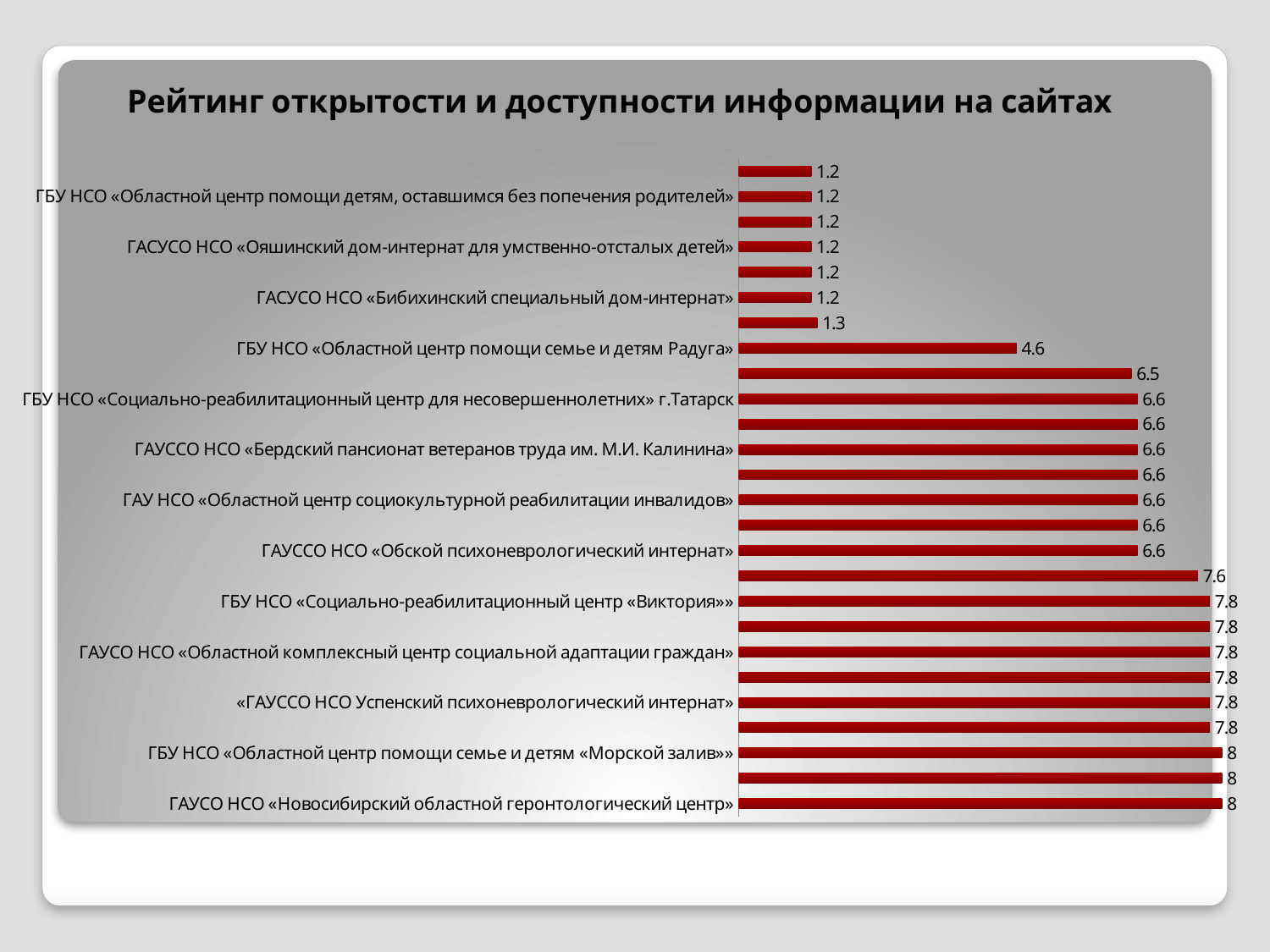
What is the difference between the values for ГБУ НСО «Областной центр помощи семье и детям «Морской залив»» and ГБУ НСО «Областной центр помощи семье и детям Радуга»? 3.4 What is the difference between the values for ГАУССО НСО «Бердский пансионат ветеранов труда им. М.И. Калинина» and ГАСУСО НСО «Ояшинский дом-интернат для умственно-отсталых детей»? 5.4 Which has a larger value: «ГАУССО НСО Успенский психоневрологический интернат» or ГАУ НСО «Областной центр социокультурной реабилитации инвалидов»? «ГАУССО НСО Успенский психоневрологический интернат» What is the title of the chart? Рейтинг открытости и доступности информации на сайтах What is the value for ГАСУСО НСО «Бибихинский специальный дом-интернат»? 1.2 What type of chart is shown on the slide? Bar chart What is the highest value shown on the chart? 8 What is the value for ГАУССО НСО «Обской психоневрологический интернат»? 6.6 What is the lowest value shown on the chart? 1.2 What is the value for ГАУСО НСО «Новосибирский областной геронтологический центр»? 8 What is the value for ГБУ НСО «Областной центр помощи семье и детям Радуга»? 4.6 What is the value for ГБУ НСО «Социально-реабилитационный центр «Виктория»»? 7.8